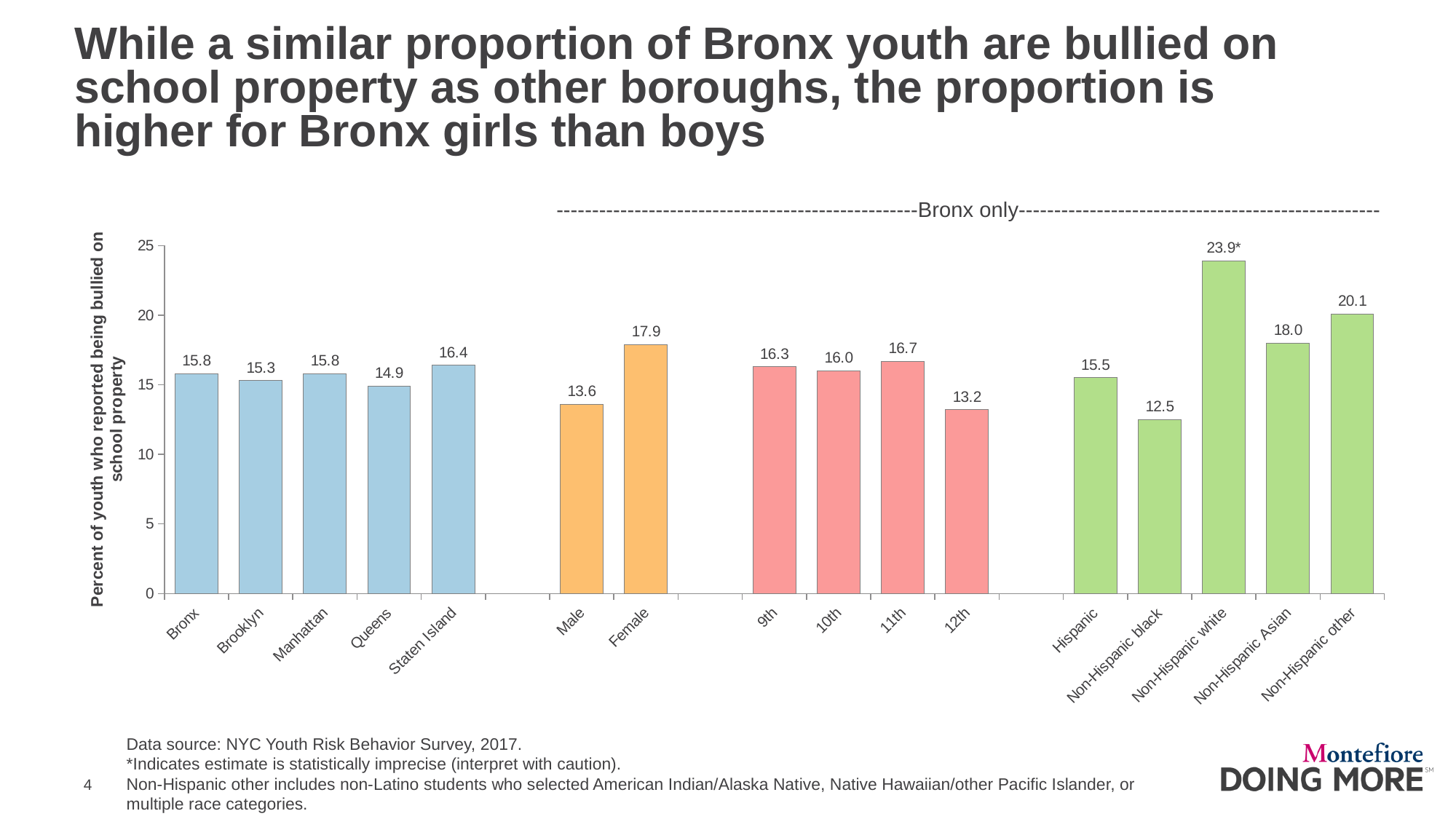
What percent of Bronx youth reported being bullied on school property? 15.8 What kind of chart is shown on the slide? Bar chart What is the value shown for 12th grade? 13.2 Which is larger, the value for Staten Island or the value for Queens? Staten Island Which category has the lowest bar in the chart? Non-Hispanic black Is the value for Non-Hispanic other greater or less than 20? greater What is the difference between the Female and Male values? 4.3 What is the label on the vertical axis of the chart? Percent of youth who reported being bullied on school property What is the value shown for Female? 17.9 Which category has the highest bar in the chart? Non-Hispanic white What is the value shown for Non-Hispanic Asian? 18.0 How many bars are plotted in the chart? 16